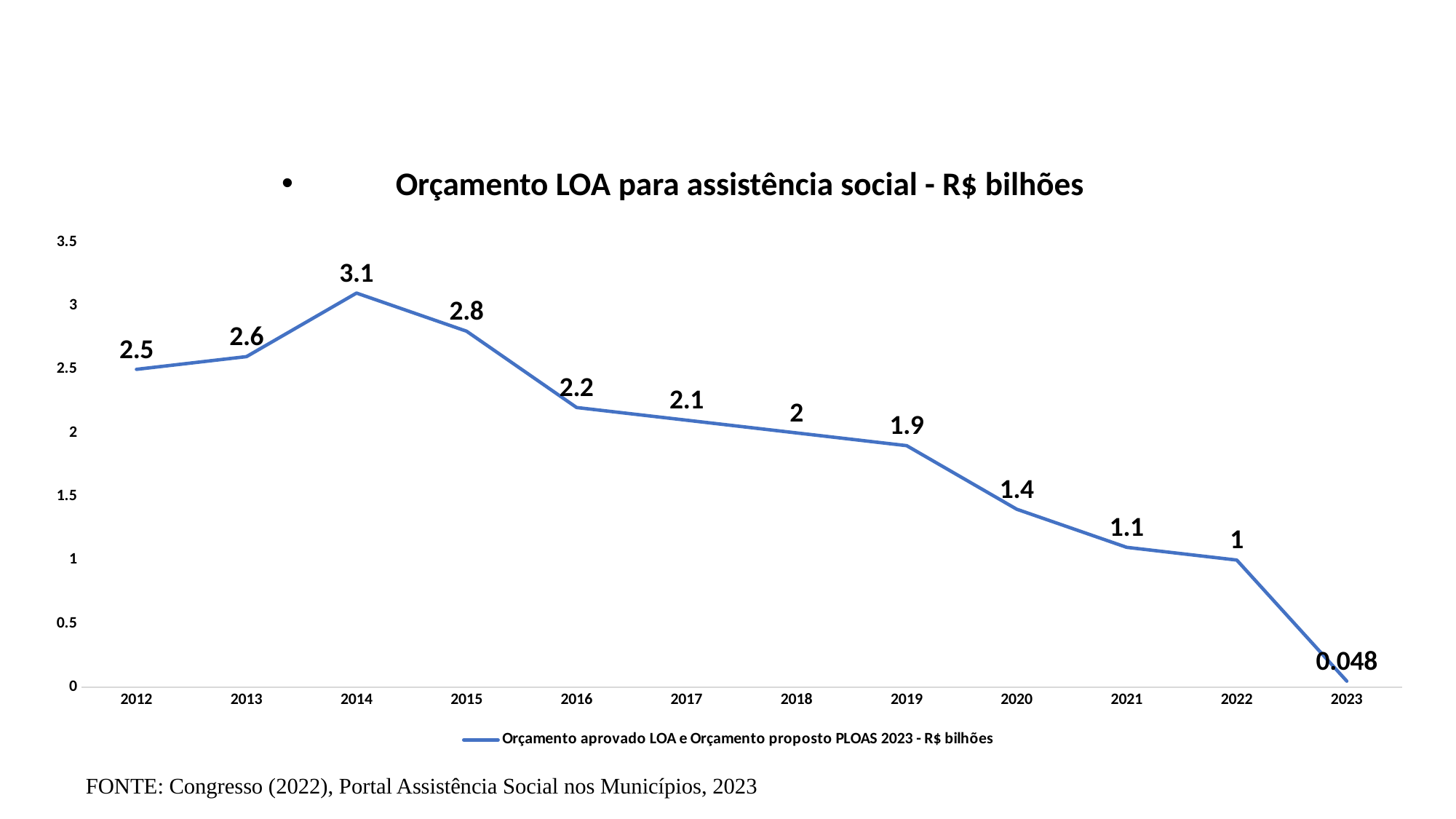
What is the difference between the values for 2014 and 2015? 0.3 What is the value for 2023? 0.048 What is the value for 2019? 1.9 Do the values rise or fall from 2014 to 2023? fall Which is larger, the value for 2013 or the value for 2020? 2013 What kind of chart is shown? line chart Which year has the highest value? 2014 Is the value for 2016 greater or less than 2? greater What is the value for 2014? 3.1 What is the difference between the values for 2012 and 2022? 1.5 Which year has the lowest value? 2023 How many years are plotted on the x axis? 12